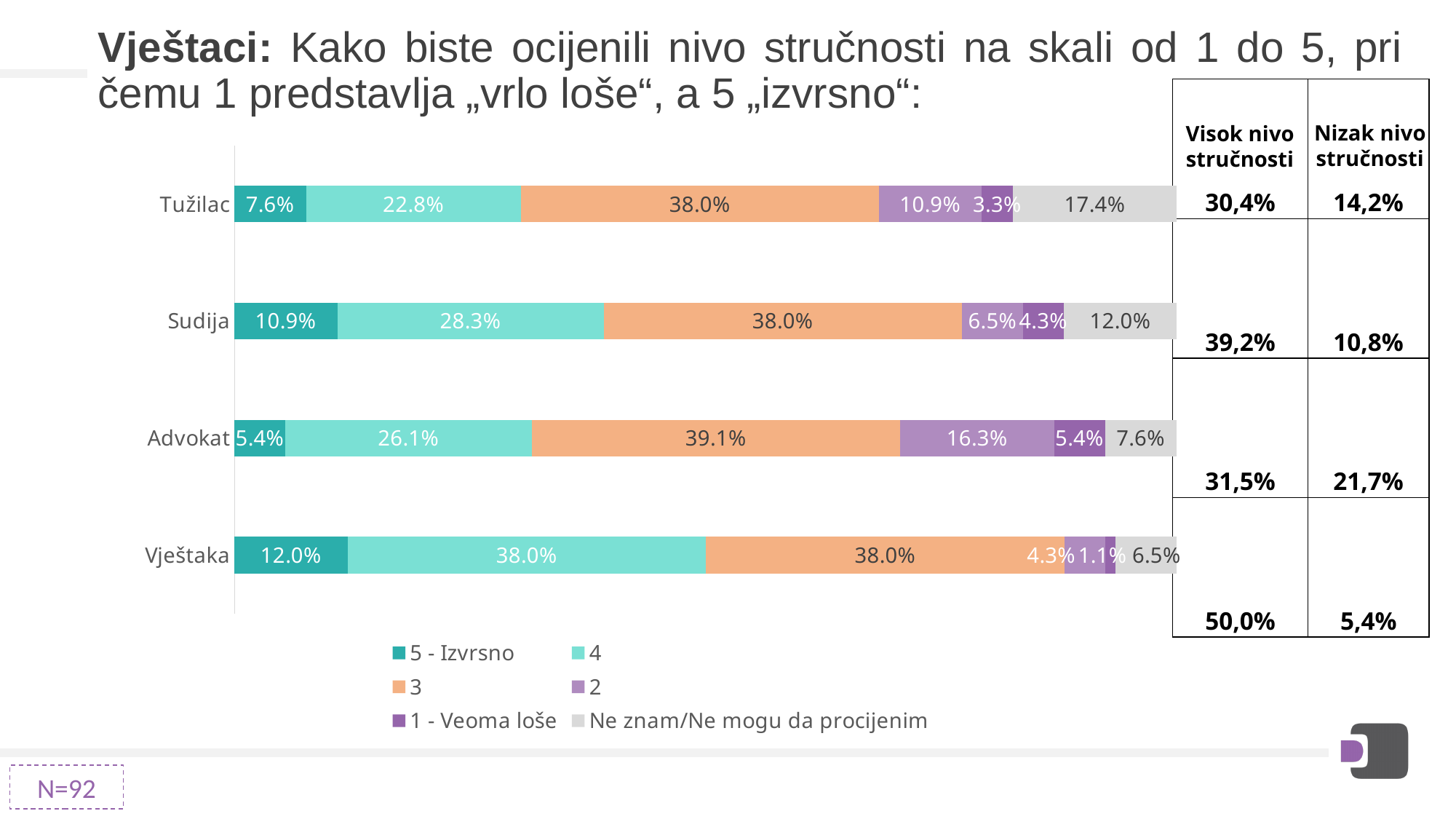
Which category has the lowest "1 - Veoma loše" value? Vještaka How many series does the legend list? 6 How much larger is the "4" value for Vještaka than for Tužilac? 15.2 percentage points What is the value of the "3" segment for Advokat? 39.1% How many categories are shown on the chart? 4 What percentage of respondents rated Sudija as "5 - Izvrsno"? 10.9% What is the total of all segments in the Tužilac bar? 100.0% What is the "Ne znam/Ne mogu da procijenim" value for Tužilac? 17.4% What kind of chart is shown on the slide? Stacked bar chart Which legend entry corresponds to the dark purple segments? 1 - Veoma loše Which category has the highest "5 - Izvrsno" value? Vještaka Which has a larger "2" value, Advokat or Sudija? Advokat